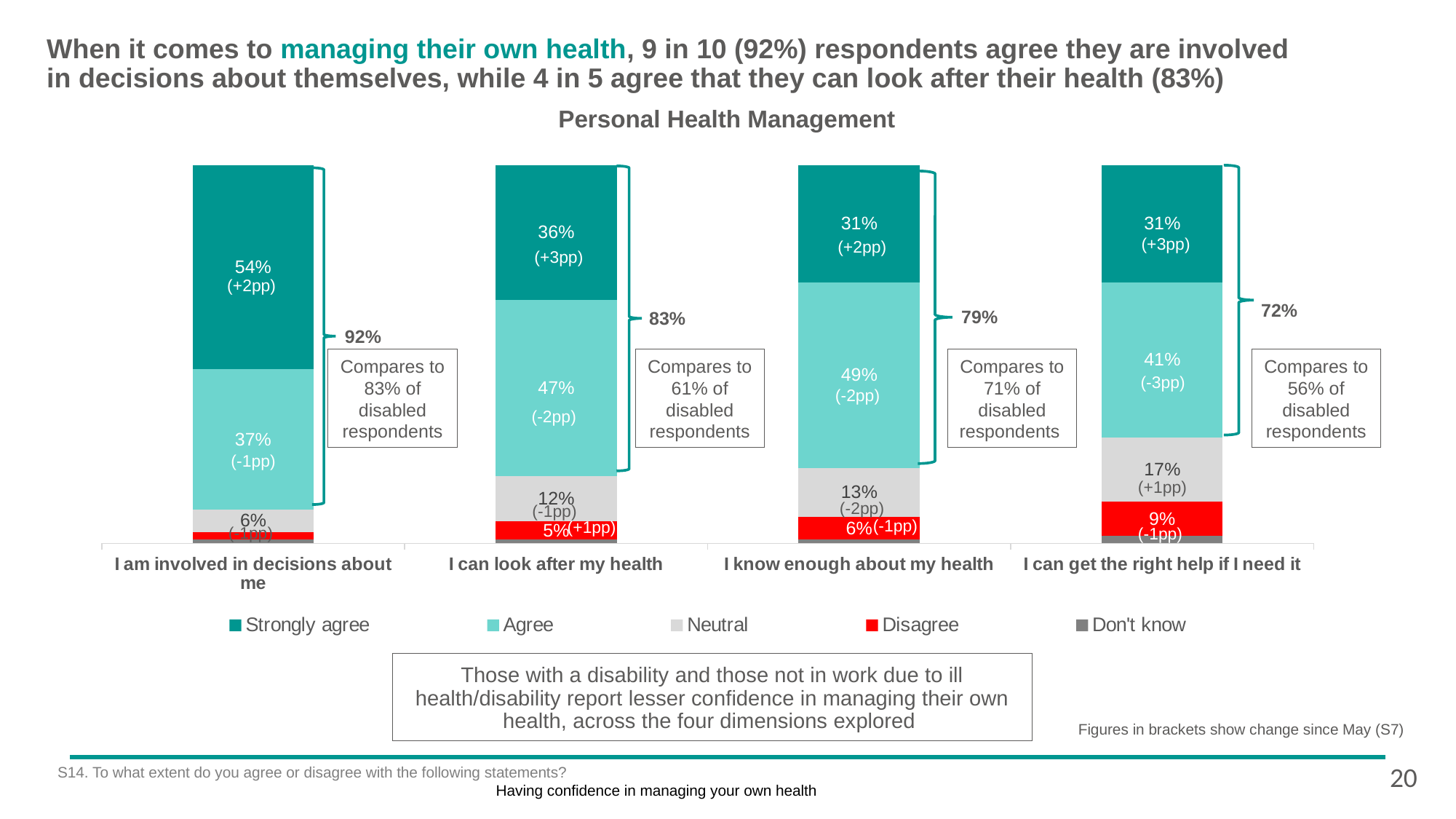
How many statements (categories) are shown on the x axis? 4 What is the title of the chart? Personal Health Management Which is larger: the 'Agree' value for 'I know enough about my health' or for 'I can get the right help if I need it'? I know enough about my health What is the 'Neutral' value for 'I can get the right help if I need it'? 17% Which statement has the highest combined agreement (strongly agree plus agree)? I am involved in decisions about me Which statement has the lowest combined agreement (strongly agree plus agree)? I can get the right help if I need it What is the 'Disagree' value for 'I know enough about my health'? 6% What percentage of respondents strongly agree with 'I am involved in decisions about me'? 54% What is the difference between the 'Strongly agree' values for 'I am involved in decisions about me' and 'I can look after my health'? 18 percentage points What is the 'Agree' value for 'I can look after my health'? 47% How many series does the legend list? 5 What type of chart is shown on the slide? stacked bar chart